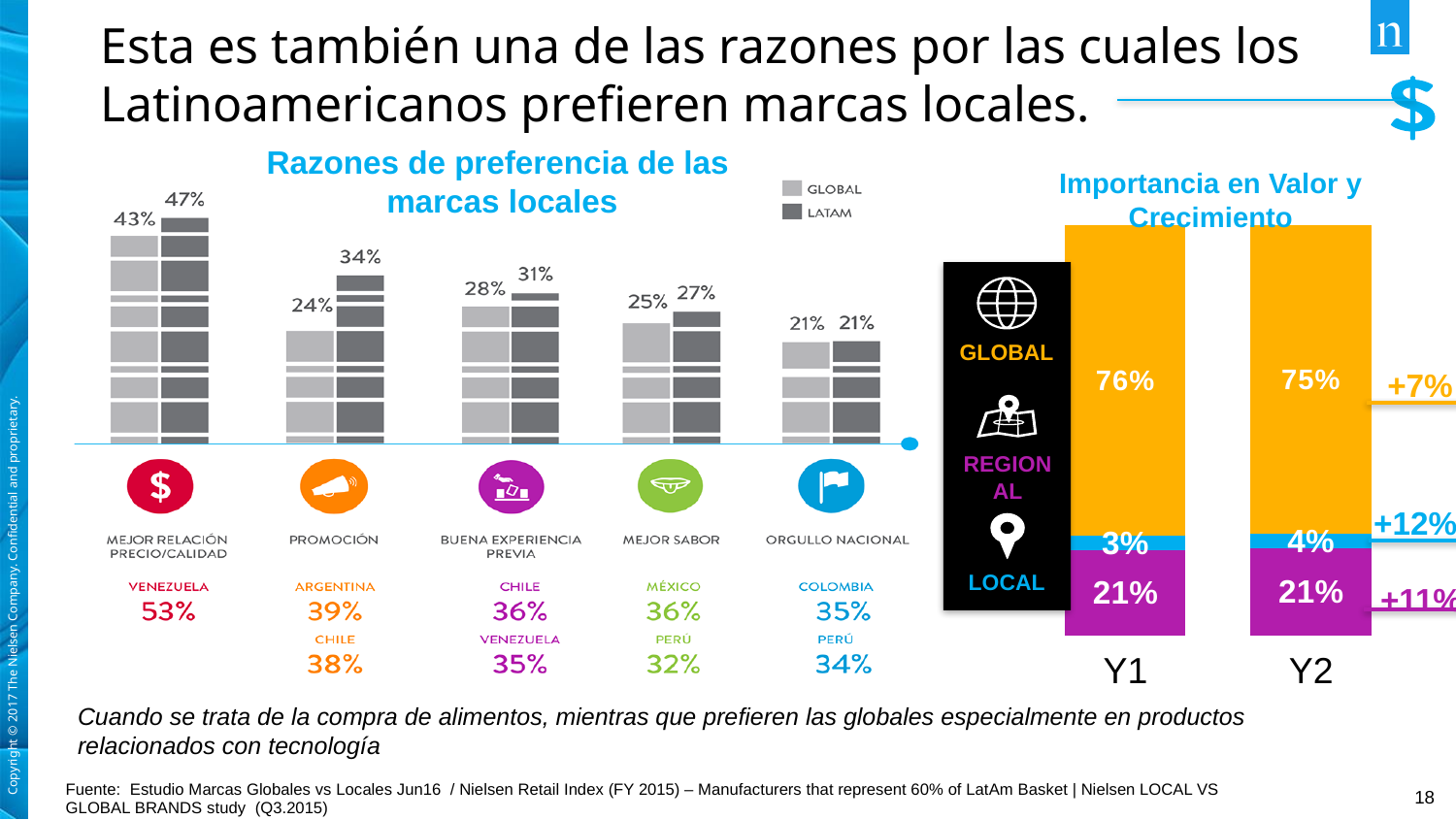
In the chart 'Razones de preferencia de las marcas locales', which reason has the highest LATAM value? Mejor relación precio/calidad In the chart 'Razones de preferencia de las marcas locales', what is the GLOBAL value for Promoción? 24% In the chart 'Razones de preferencia de las marcas locales', which reason has the lowest GLOBAL value? Orgullo nacional In the chart 'Razones de preferencia de las marcas locales', is the LATAM value for Buena experiencia previa larger or smaller than the LATAM value for Mejor sabor? larger In the chart 'Importancia en Valor y Crecimiento', what is the total of the Y1 stacked bar? 100% In the chart 'Razones de preferencia de las marcas locales', how many series does the legend list? 2 In the chart 'Razones de preferencia de las marcas locales', how many reasons (categories) are shown? 5 In the chart 'Importancia en Valor y Crecimiento', what is the REGIONAL share in Y1? 3% In the chart 'Importancia en Valor y Crecimiento', what is the GLOBAL share in Y2? 75% In the chart 'Razones de preferencia de las marcas locales', what is the difference between the LATAM and GLOBAL values for Promoción? 10% In the chart 'Razones de preferencia de las marcas locales', what is the LATAM value for Mejor relación precio/calidad? 47% What kind of chart is 'Razones de preferencia de las marcas locales'? bar chart